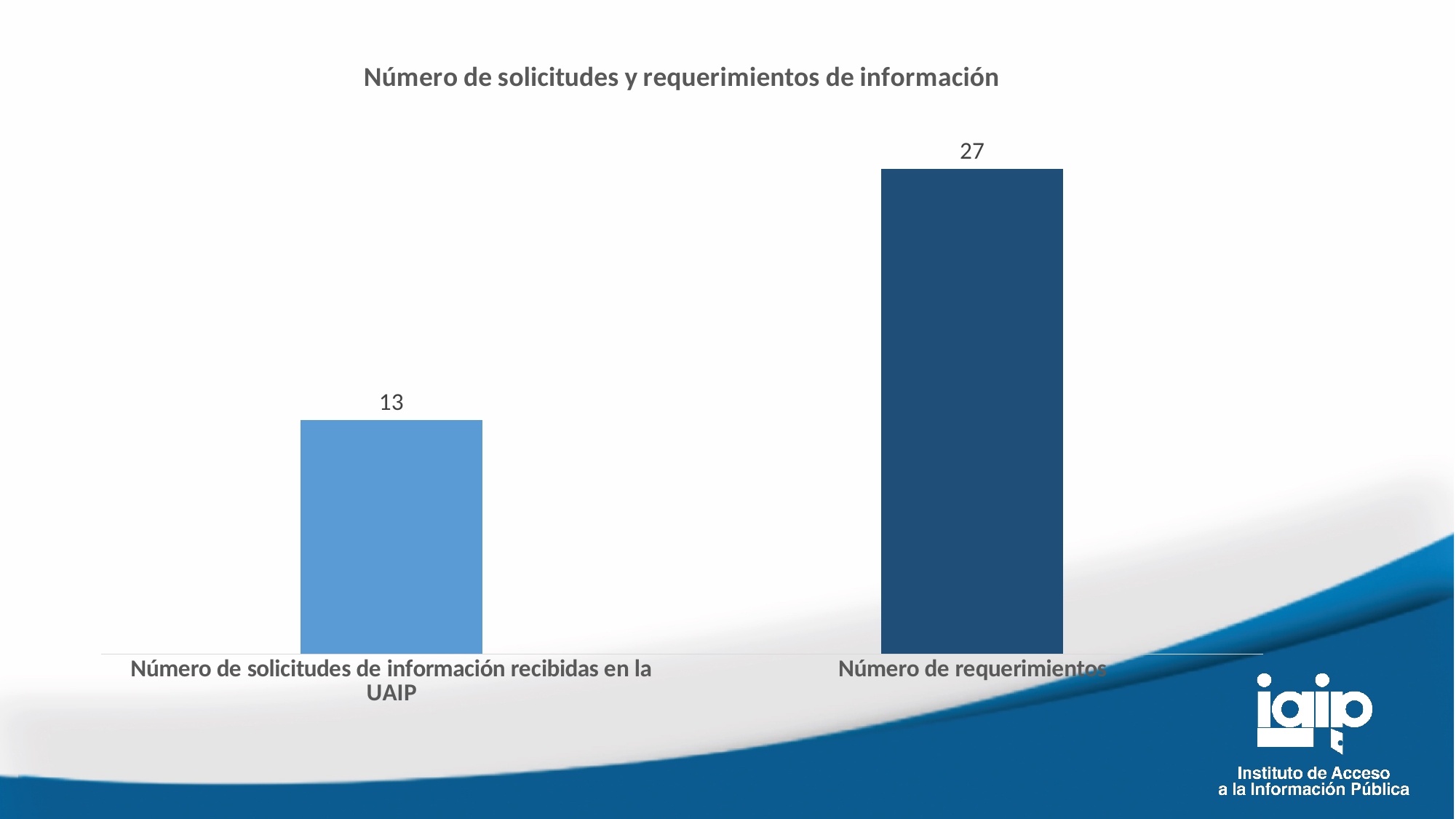
What is the total of the two values shown in the chart? 40 Which category has the lowest value? Número de solicitudes de información recibidas en la UAIP What is the value for 'Número de requerimientos'? 27 What is the value for 'Número de solicitudes de información recibidas en la UAIP'? 13 How many categories are shown in the chart? 2 What is the title of the chart? Número de solicitudes y requerimientos de información What is the difference between the value for 'Número de requerimientos' and the value for 'Número de solicitudes de información recibidas en la UAIP'? 14 Which is larger: the value for 'Número de requerimientos' or the value for 'Número de solicitudes de información recibidas en la UAIP'? Número de requerimientos What colour is the bar for 'Número de requerimientos'? Dark blue Which category has the highest value? Número de requerimientos What kind of chart is shown on the slide? Bar chart